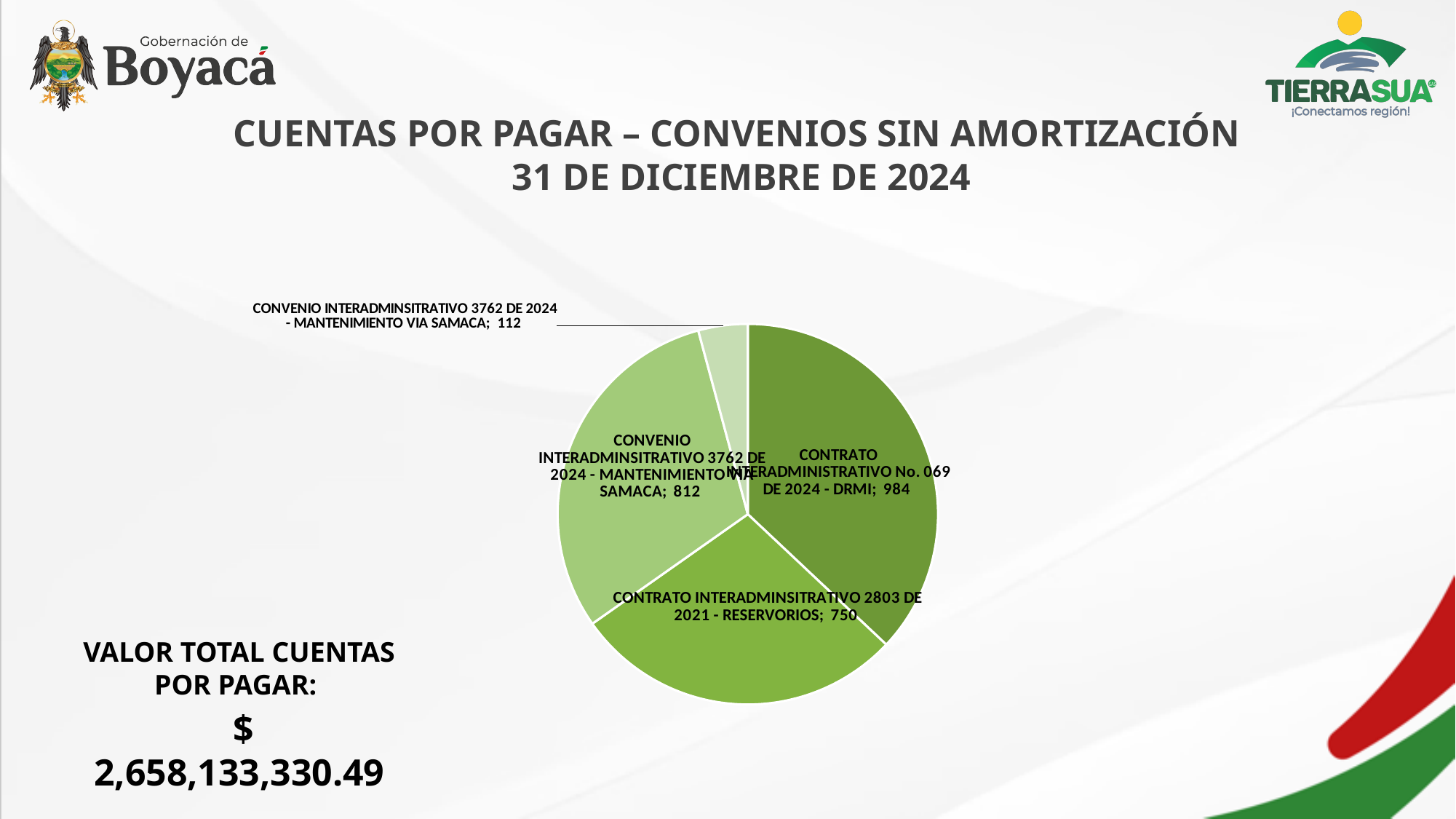
What is the difference between the larger MANTENIMIENTO VIA SAMACA slice (812) and the RESERVORIOS slice (750)? 62 What is the value of the smallest slice in the pie chart? 112 What kind of chart is shown on the slide? pie chart Which slice of the pie chart has the largest value? CONTRATO INTERADMINISTRATIVO No. 069 DE 2024 - DRMI What is the VALOR TOTAL CUENTAS POR PAGAR stated on the slide? $ 2,658,133,330.49 How many slices does the pie chart have? 4 What is the title shown above the chart? CUENTAS POR PAGAR – CONVENIOS SIN AMORTIZACIÓN 31 DE DICIEMBRE DE 2024 What is the difference between the DRMI slice (984) and the RESERVORIOS slice (750)? 234 What is the value shown for CONTRATO INTERADMINISTRATIVO No. 069 DE 2024 - DRMI? 984 What is the sum of all four slice values in the pie chart? 2658 What is the value shown for CONTRATO INTERADMINSITRATIVO 2803 DE 2021 - RESERVORIOS? 750 Which is larger: the DRMI slice or the larger MANTENIMIENTO VIA SAMACA slice (812)? DRMI